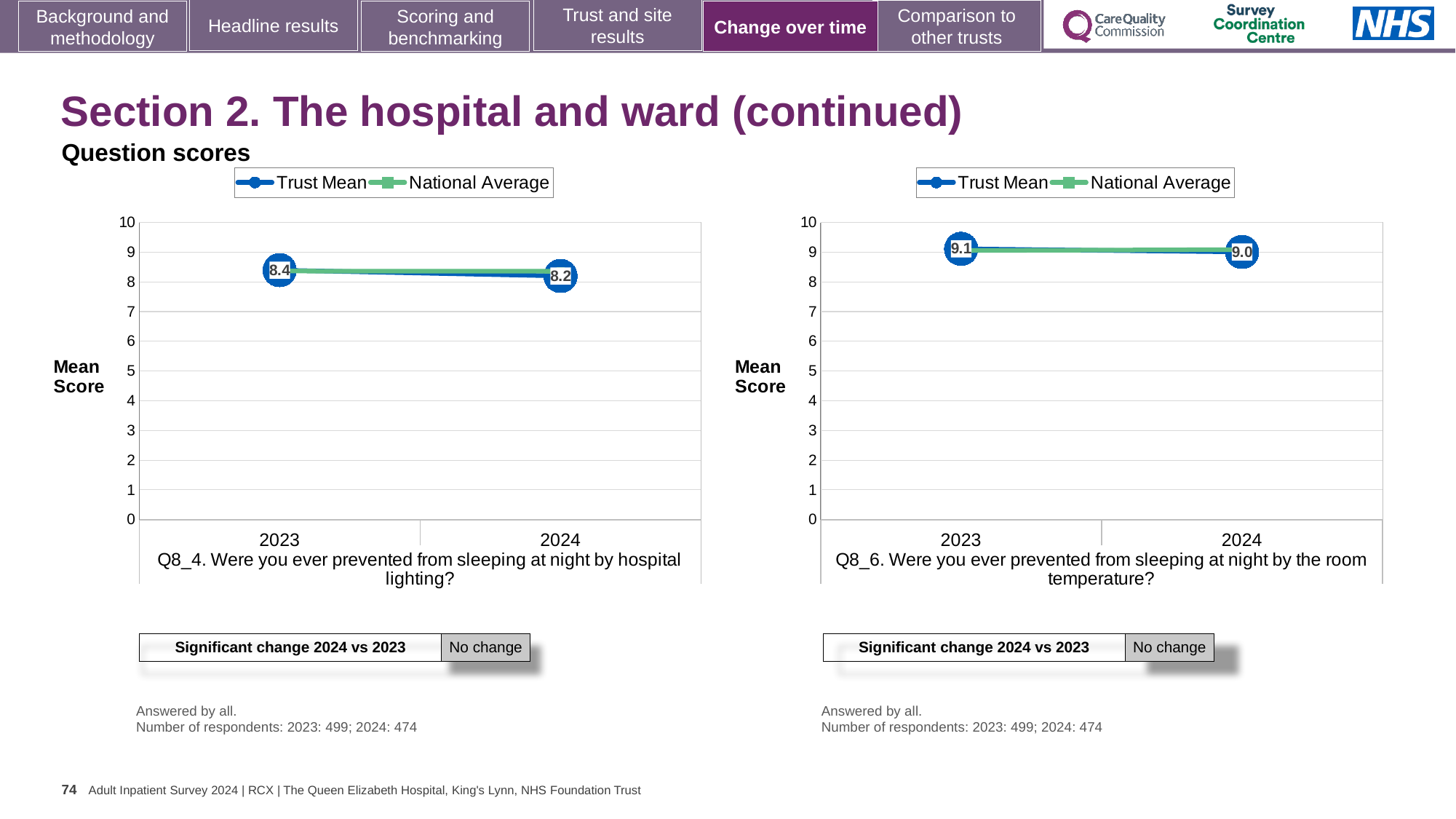
On the left chart (Q8_4), by how much did the Trust Mean change from 2023 to 2024? 0.2 On the left chart (Q8_4), is the National Average for 2024 greater or less than 7? greater On the left chart (Q8_4), what is the Trust Mean score for 2023? 8.4 On the left chart (Q8_4), does the Trust Mean rise or fall from 2023 to 2024? fall On the right chart (Q8_6), what is the Trust Mean score for 2023? 9.1 On the left chart (Q8_4), what is the Trust Mean score for 2024? 8.2 On the right chart (Q8_6), what is the Trust Mean score for 2024? 9.0 How many years are plotted on the x axis of the right chart (Q8_6)? 2 What kind of chart is the left chart (Q8_4)? line chart On the right chart (Q8_6), which year has the higher Trust Mean, 2023 or 2024? 2023 On the right chart (Q8_6), what is the difference between the Trust Mean for 2023 and 2024? 0.1 How many series does the legend of the right chart (Q8_6) list? 2